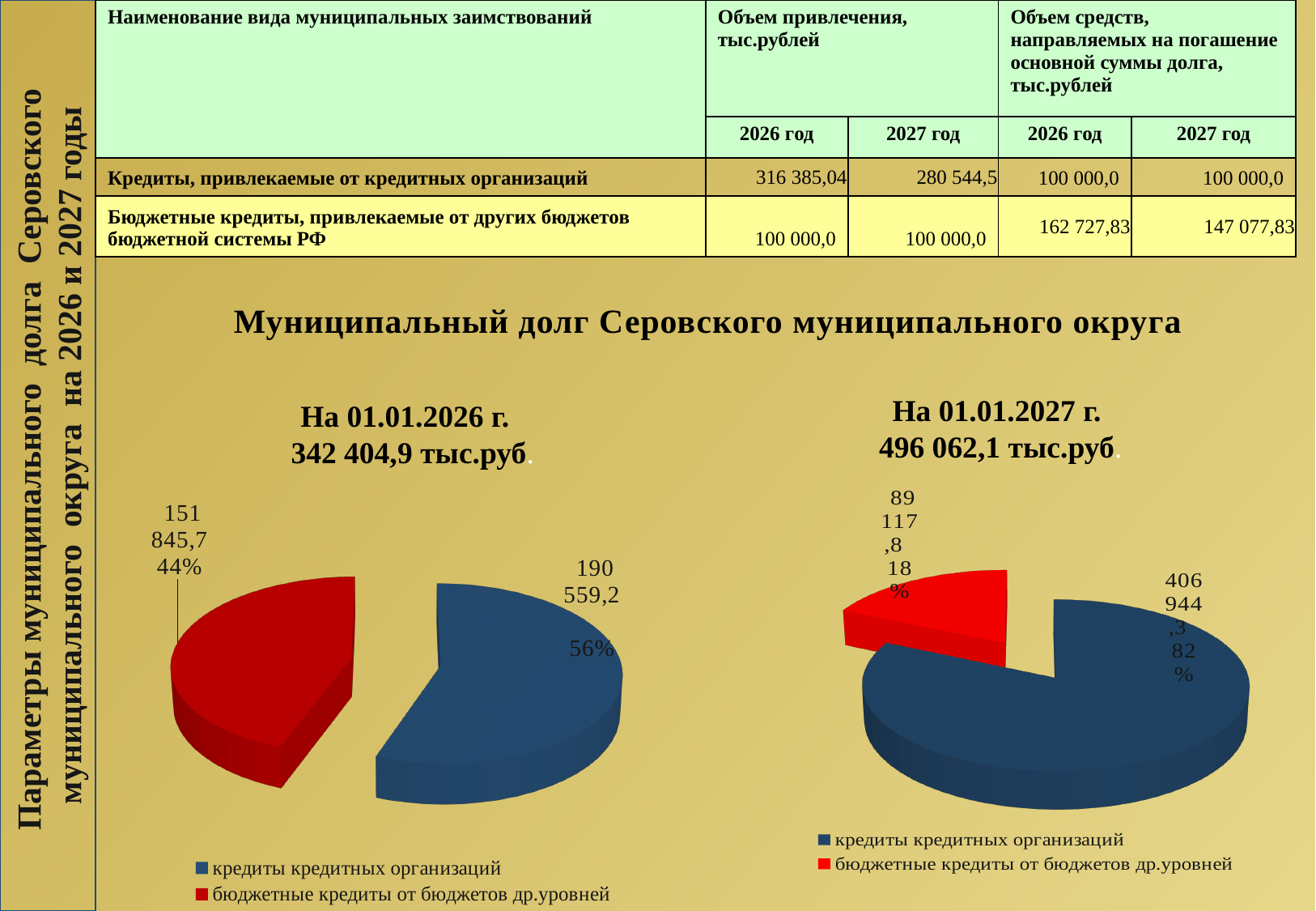
What type of chart is used for 01.01.2027? pie chart How many slices does the pie chart for 01.01.2026 have? 2 In the pie chart for 01.01.2026, what is the value for бюджетные кредиты от бюджетов др.уровней? 151 845,7 In the pie chart for 01.01.2026, what is the value for кредиты кредитных организаций? 190 559,2 In the pie chart for 01.01.2026, what share of the pie is кредиты кредитных организаций? 56% In the pie chart for 01.01.2027, which category is the largest? кредиты кредитных организаций In the pie chart for 01.01.2026, which category is the smallest? бюджетные кредиты от бюджетов др.уровней In the pie chart for 01.01.2026, what is the difference between кредиты кредитных организаций and бюджетные кредиты от бюджетов др.уровней? 38 713,5 In the pie chart for 01.01.2027, which is larger: кредиты кредитных организаций or бюджетные кредиты от бюджетов др.уровней? кредиты кредитных организаций In the pie chart for 01.01.2027, what is the value for бюджетные кредиты от бюджетов др.уровней? 89 117,8 In the pie chart for 01.01.2027, what share of the pie is бюджетные кредиты от бюджетов др.уровней? 18% In the pie chart for 01.01.2027, what is the value for кредиты кредитных организаций? 406 944,3